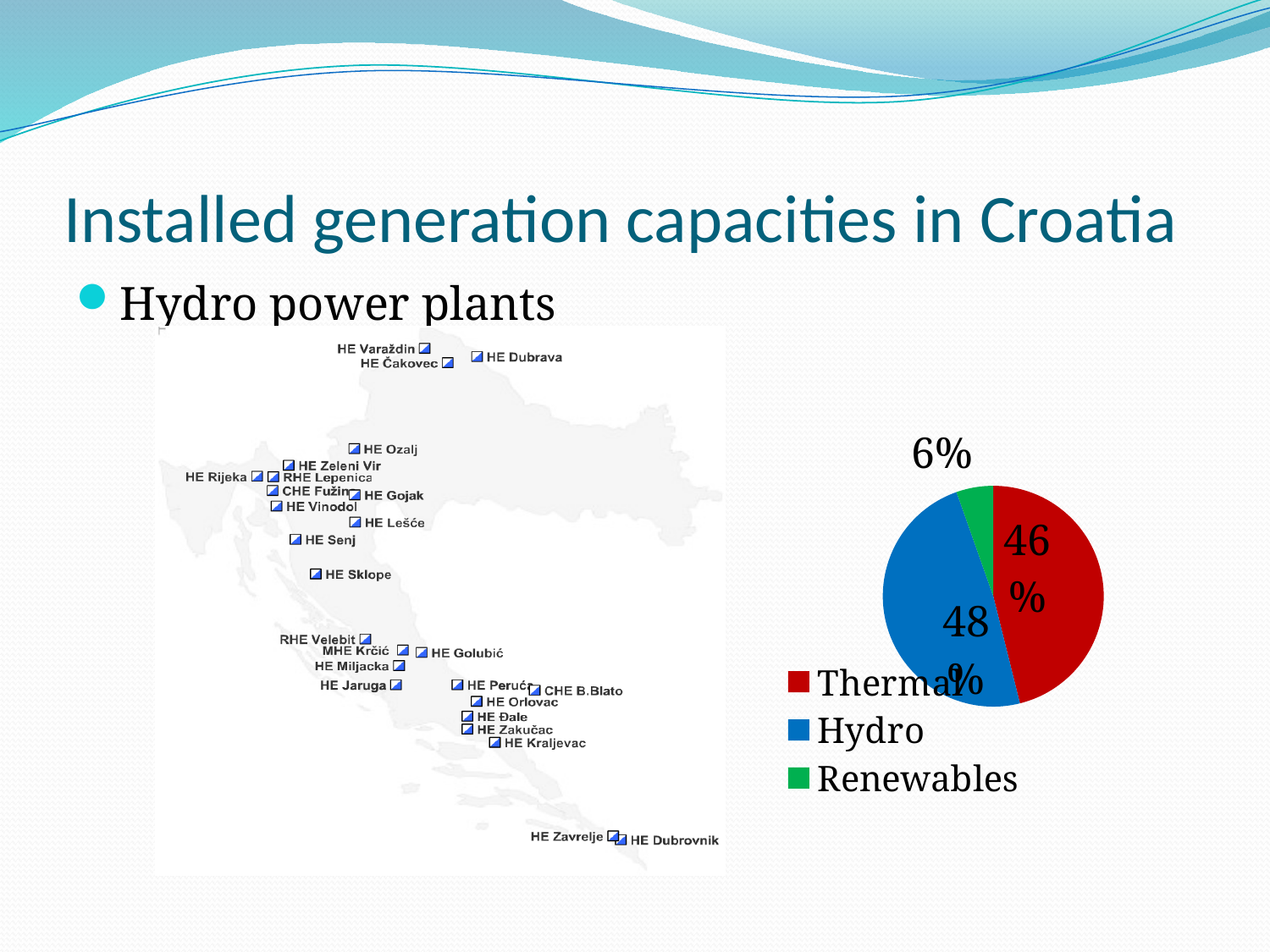
How many entries does the pie chart legend list? 3 Which is larger in the pie chart, Thermal or Renewables? Thermal Which category has the smallest share in the pie chart? Renewables Which category has the largest share in the pie chart? Hydro How many percentage points larger is the Hydro share than the Thermal share? 2 What share of installed generation capacity is Thermal in the pie chart? 46% How many slices does the pie chart have? 3 How many percentage points larger is the Thermal share than the Renewables share? 40 What share of installed generation capacity is Hydro in the pie chart? 48% What kind of chart is shown on the slide? pie chart What colour is the Hydro slice in the pie chart? blue What share of installed generation capacity is Renewables in the pie chart? 6%